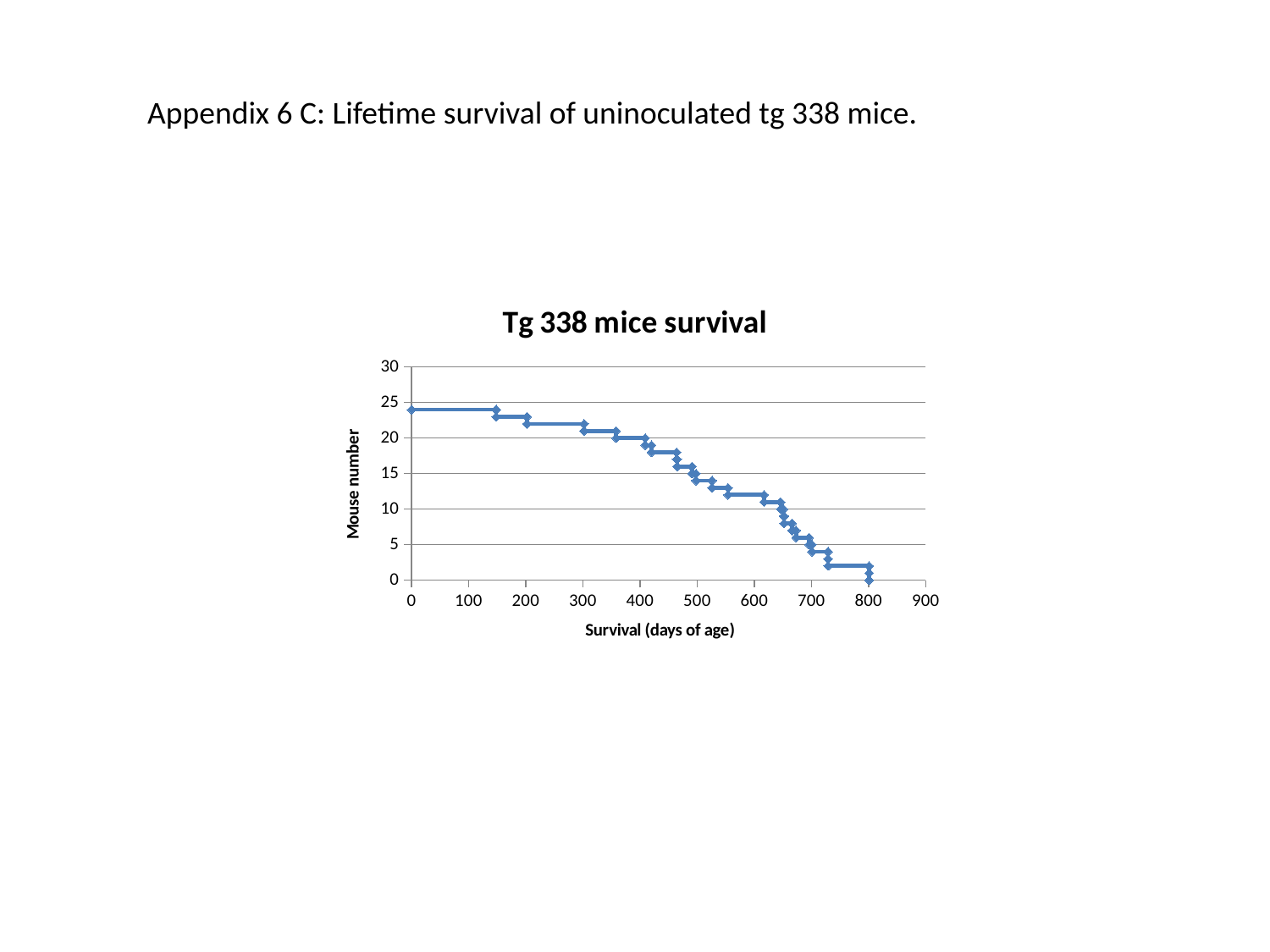
Is the mouse number at 600 days of age greater or less than 10? greater What type of chart is shown on the slide? line chart What is the title of the chart? Tg 338 mice survival Is the mouse number at 0 days of age greater or less than 20? greater Is the mouse number higher at 100 days of age or at 700 days of age? 100 days of age Does the mouse number rise or fall as survival days increase along the x axis? fall What is the highest value shown on the y axis of the chart? 30 What mouse number does the curve reach at its final point, at about 800 days of age? 0 Is the mouse number at 300 days of age greater or less than 20? greater What is the label of the x axis of the chart? Survival (days of age)